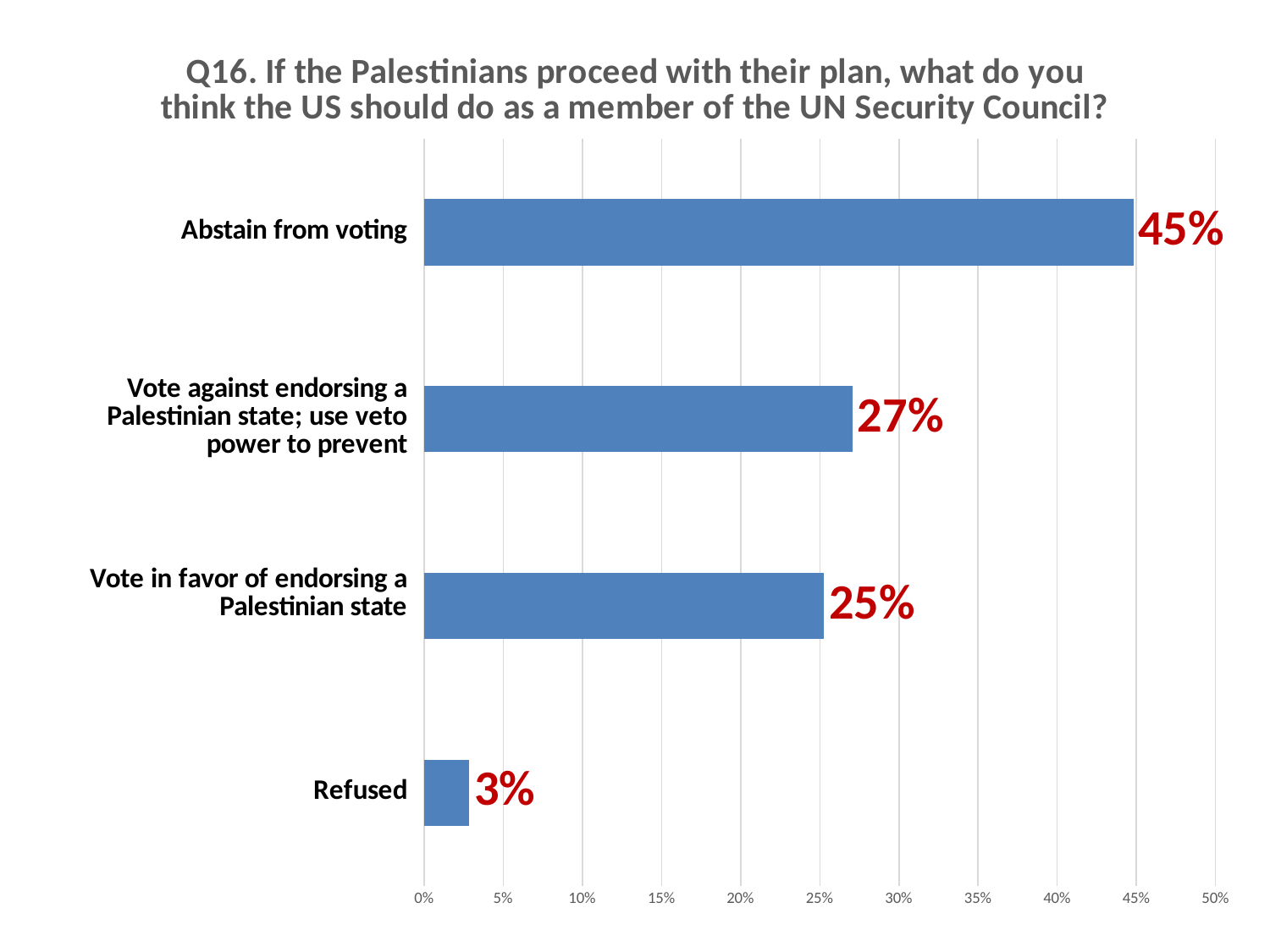
What percentage of respondents said the US should abstain from voting? 45% What is the value for 'Vote against endorsing a Palestinian state; use veto power to prevent'? 27% What kind of chart is shown on the slide? Bar chart What is the difference between 'Vote against endorsing a Palestinian state; use veto power to prevent' and 'Vote in favor of endorsing a Palestinian state'? 2% How many response categories are shown in the chart? 4 Is the value for 'Abstain from voting' greater or less than 40%? greater What is the difference between 'Abstain from voting' and 'Vote in favor of endorsing a Palestinian state'? 20% Which response option has the highest value? Abstain from voting What percentage of respondents refused to answer? 3% Which response option has the lowest value? Refused What is the value for 'Vote in favor of endorsing a Palestinian state'? 25% Which is larger: the value for 'Abstain from voting' or the value for 'Vote against endorsing a Palestinian state; use veto power to prevent'? Abstain from voting